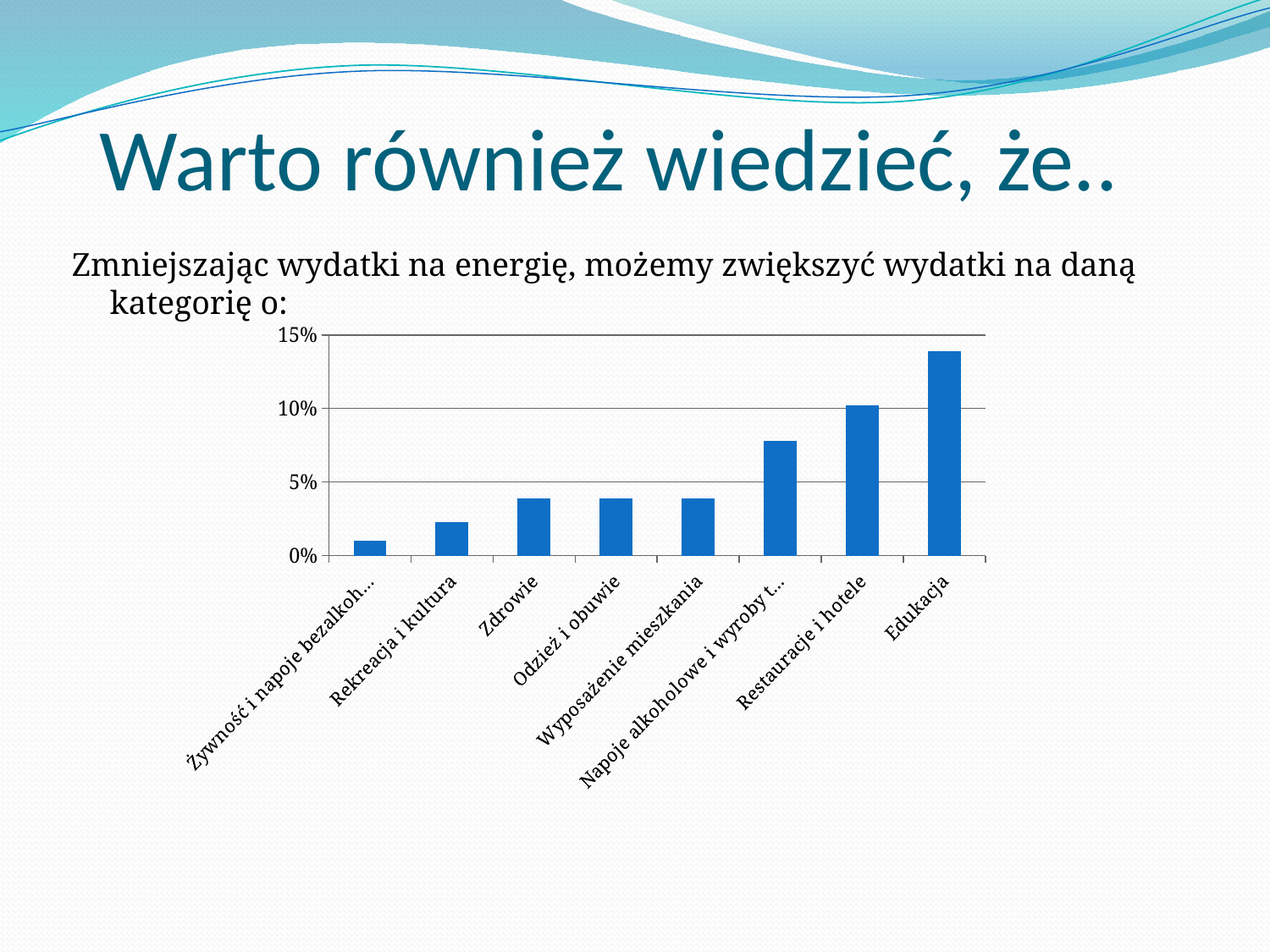
Which is larger, the value for Rekreacja i kultura or the value for Zdrowie? Zdrowie Is the value for Edukacja greater or less than 10%? greater Which is larger, the value for Edukacja or the value for Restauracje i hotele? Edukacja How many categories are plotted in the chart? 8 Do the values generally rise or fall from left to right along the x axis? rise What kind of chart is shown on the slide? bar chart Is the value for Napoje alkoholowe i wyroby t... greater or less than 10%? less Is the value for Rekreacja i kultura greater or less than 5%? less Which category has the lowest value in the chart? Żywność i napoje bezalkoh... Which category has the highest value in the chart? Edukacja